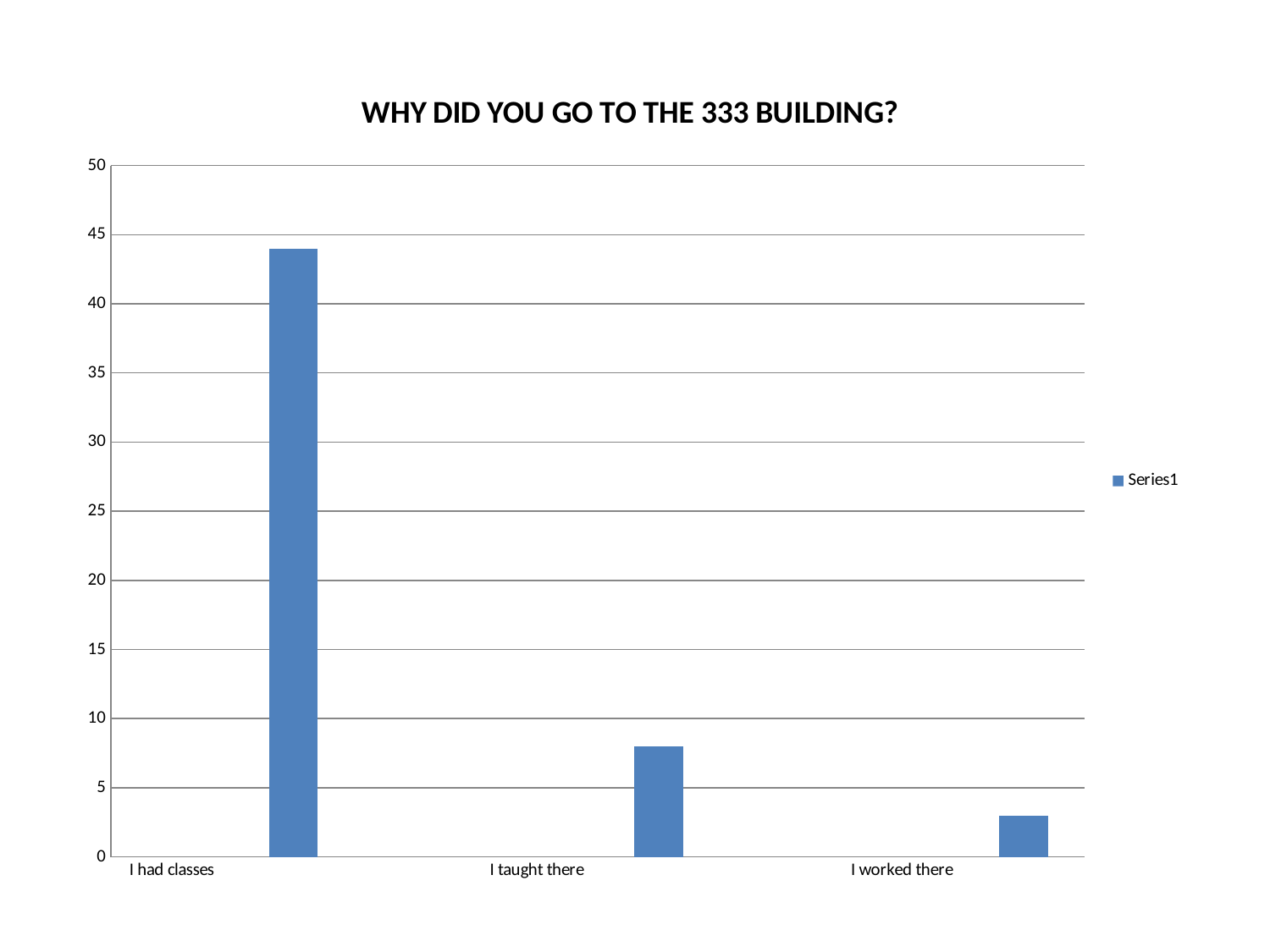
Is the value for "I worked there" greater or less than 5? less Which category has the lowest value? I worked there Which category has the highest value? I had classes How many categories are shown on the x axis? 3 What is the name of the series shown in the legend? Series1 Is the value for "I had classes" greater or less than 40? greater Is the value for "I taught there" greater or less than 10? less What is the title of the chart? WHY DID YOU GO TO THE 333 BUILDING? Do the values rise or fall from left to right along the x axis? fall Which is larger, the value for "I taught there" or the value for "I worked there"? I taught there What kind of chart is shown on the slide? bar chart How many series does the legend list? 1